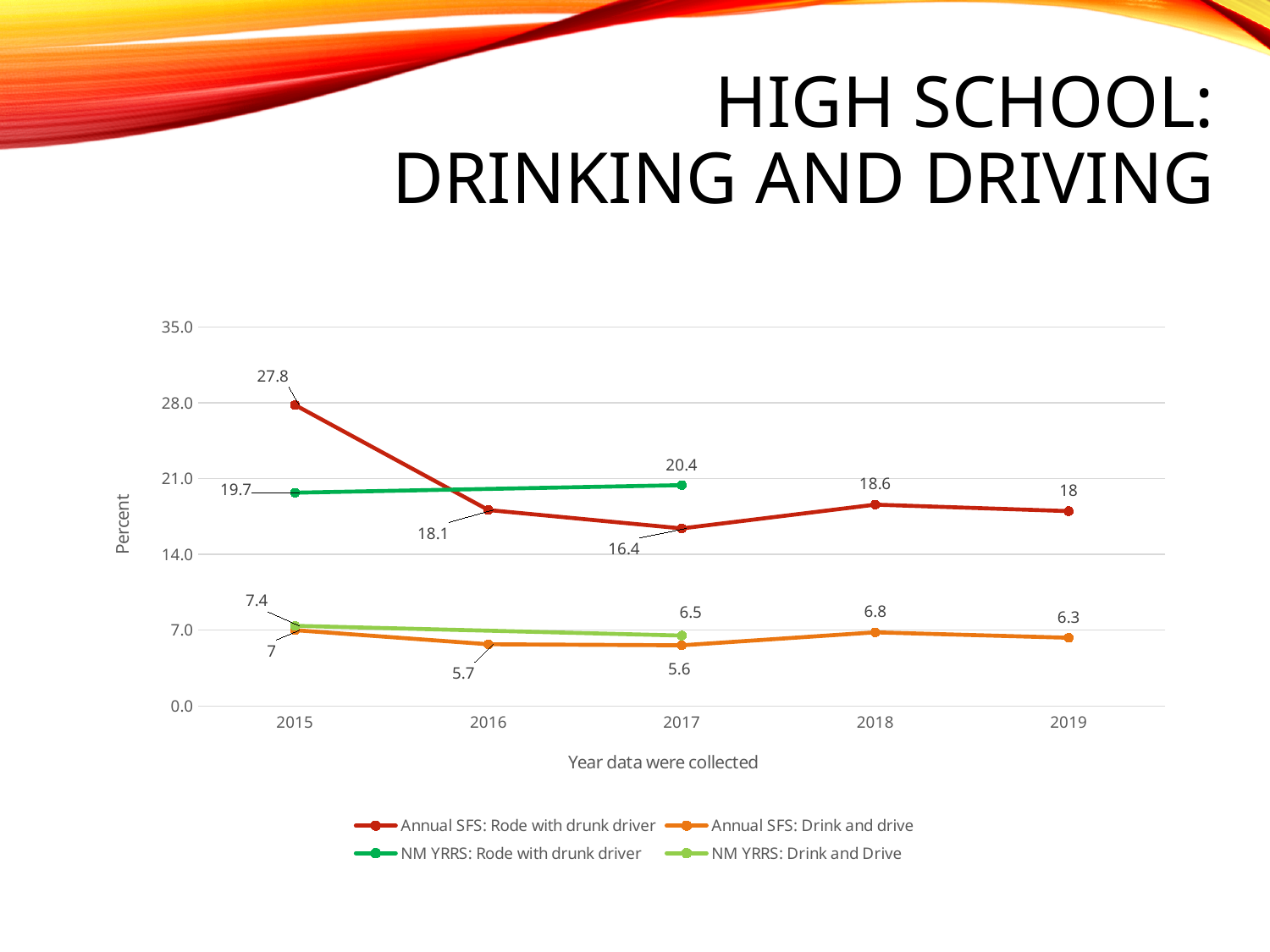
What is the difference between the Annual SFS: Rode with drunk driver values for 2015 and 2016? 9.7 What type of chart is shown on the slide? line chart How many series does the legend list? 4 What is the label of the y axis? Percent What is the value for NM YRRS: Drink and Drive in 2015? 7.4 In which year is Annual SFS: Rode with drunk driver lowest? 2017 How many years are shown on the x axis? 5 In which year is Annual SFS: Drink and drive highest? 2015 What is the value for Annual SFS: Rode with drunk driver in 2015? 27.8 What is the value for NM YRRS: Rode with drunk driver in 2017? 20.4 Which is larger in 2017: Annual SFS: Rode with drunk driver or NM YRRS: Rode with drunk driver? NM YRRS: Rode with drunk driver What is the value for Annual SFS: Drink and drive in 2016? 5.7